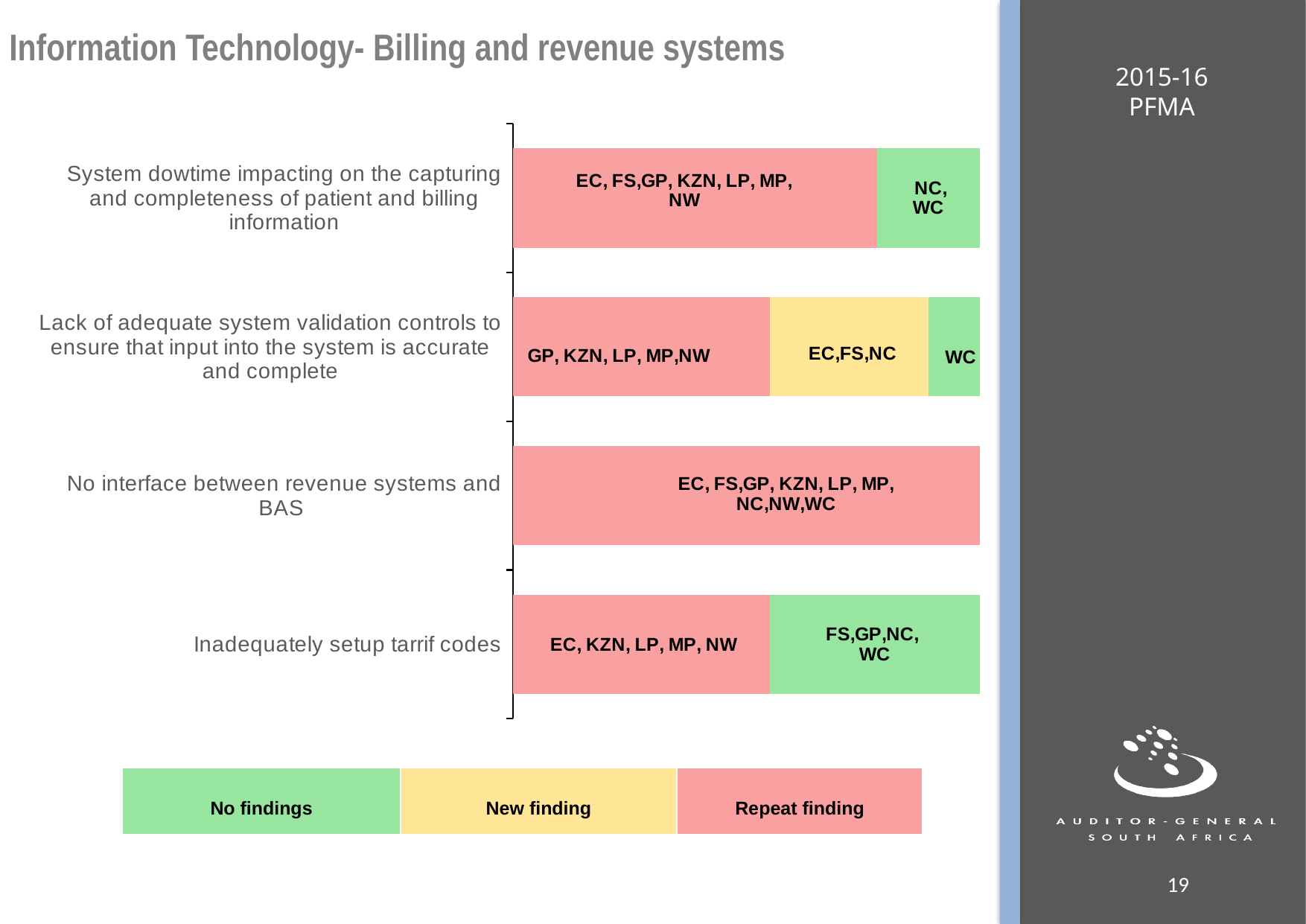
How many categories (findings) are plotted on the chart? 4 Which finding has a 'Repeat finding' segment covering all provinces (EC, FS, GP, KZN, LP, MP, NC, NW, WC)? No interface between revenue systems and BAS Which legend entry is shown in red/pink? Repeat finding How many provinces are listed in the 'Repeat finding' segment for 'Inadequately setup tarrif codes'? 5 Which provinces are labelled as 'New finding' for 'Lack of adequate system validation controls to ensure that input into the system is accurate and complete'? EC, FS, NC What kind of chart is shown on the slide? Stacked bar chart Which provinces are labelled as 'No findings' for 'Inadequately setup tarrif codes'? FS, GP, NC, WC Which province is the only one labelled as 'No findings' for 'Lack of adequate system validation controls to ensure that input into the system is accurate and complete'? WC For 'System dowtime impacting on the capturing and completeness of patient and billing information', is the 'Repeat finding' segment larger or smaller than the 'No findings' segment? Larger Which provinces are labelled as 'Repeat finding' for 'System dowtime impacting on the capturing and completeness of patient and billing information'? EC, FS, GP, KZN, LP, MP, NW How many series does the legend list? 3 Which finding is the only one with a 'New finding' segment? Lack of adequate system validation controls to ensure that input into the system is accurate and complete